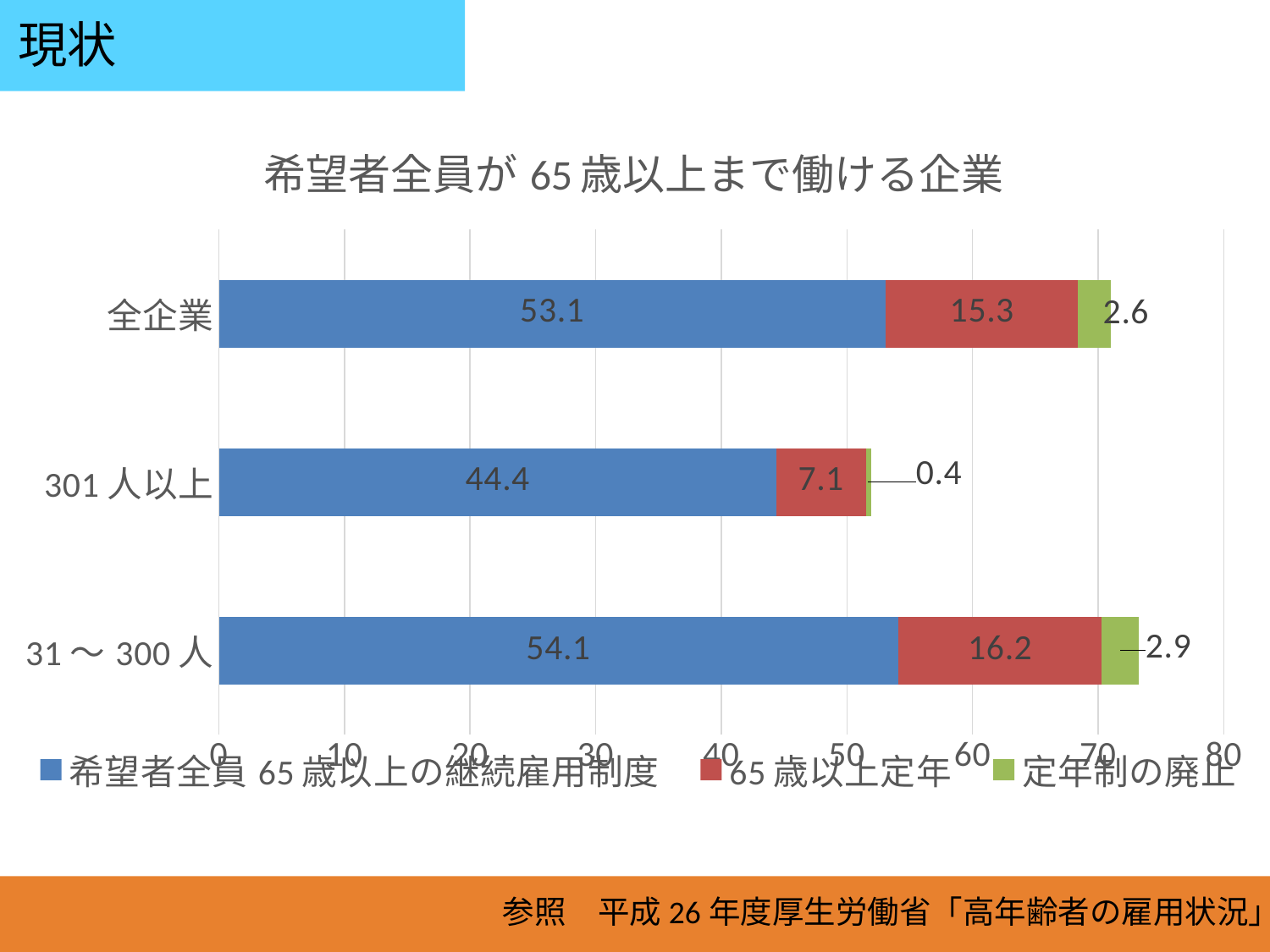
How many series does the legend list? 3 What is the value of 希望者全員65歳以上の継続雇用制度 for 全企業? 53.1 What is the total of the stacked bar for 301人以上? 51.9 What is the total of the stacked bar for 全企業? 71.0 What is the difference between the 65歳以上定年 values for 31～300人 and 301人以上? 9.1 Which category has the highest value for 希望者全員65歳以上の継続雇用制度? 31～300人 How many categories are shown on the chart? 3 What is the value of 定年制の廃止 for 31～300人? 2.9 Which is larger: the 希望者全員65歳以上の継続雇用制度 value for 全企業 or for 301人以上? 全企業 Which category has the lowest value for 定年制の廃止? 301人以上 What kind of chart is shown on the slide? Stacked bar chart What is the value of 65歳以上定年 for 301人以上? 7.1